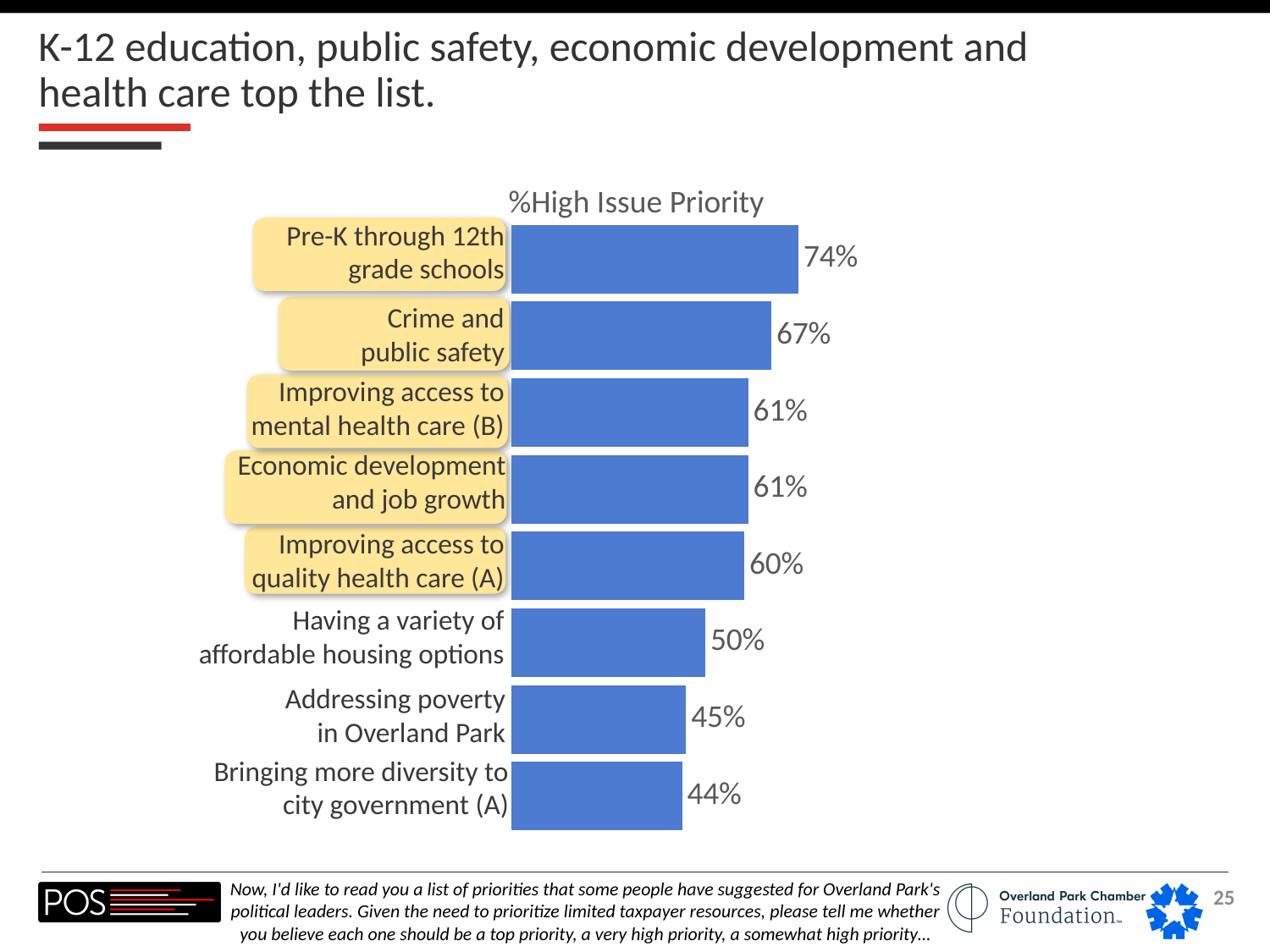
What is the difference between the values for Improving access to quality health care (A) and Bringing more diversity to city government (A)? 16% Which category has the highest value? Pre-K through 12th grade schools What is the value for Addressing poverty in Overland Park? 45% What is the value for Crime and public safety? 67% How many categories are shown in the chart? 8 What is the value for Having a variety of affordable housing options? 50% What is the difference between the values for Pre-K through 12th grade schools and Crime and public safety? 7% Which category has the lowest value? Bringing more diversity to city government (A) Which is larger, the value for Crime and public safety or the value for Economic development and job growth? Crime and public safety What kind of chart is shown on the slide? Bar chart What is the title of the chart? %High Issue Priority What is the value for Pre-K through 12th grade schools? 74%